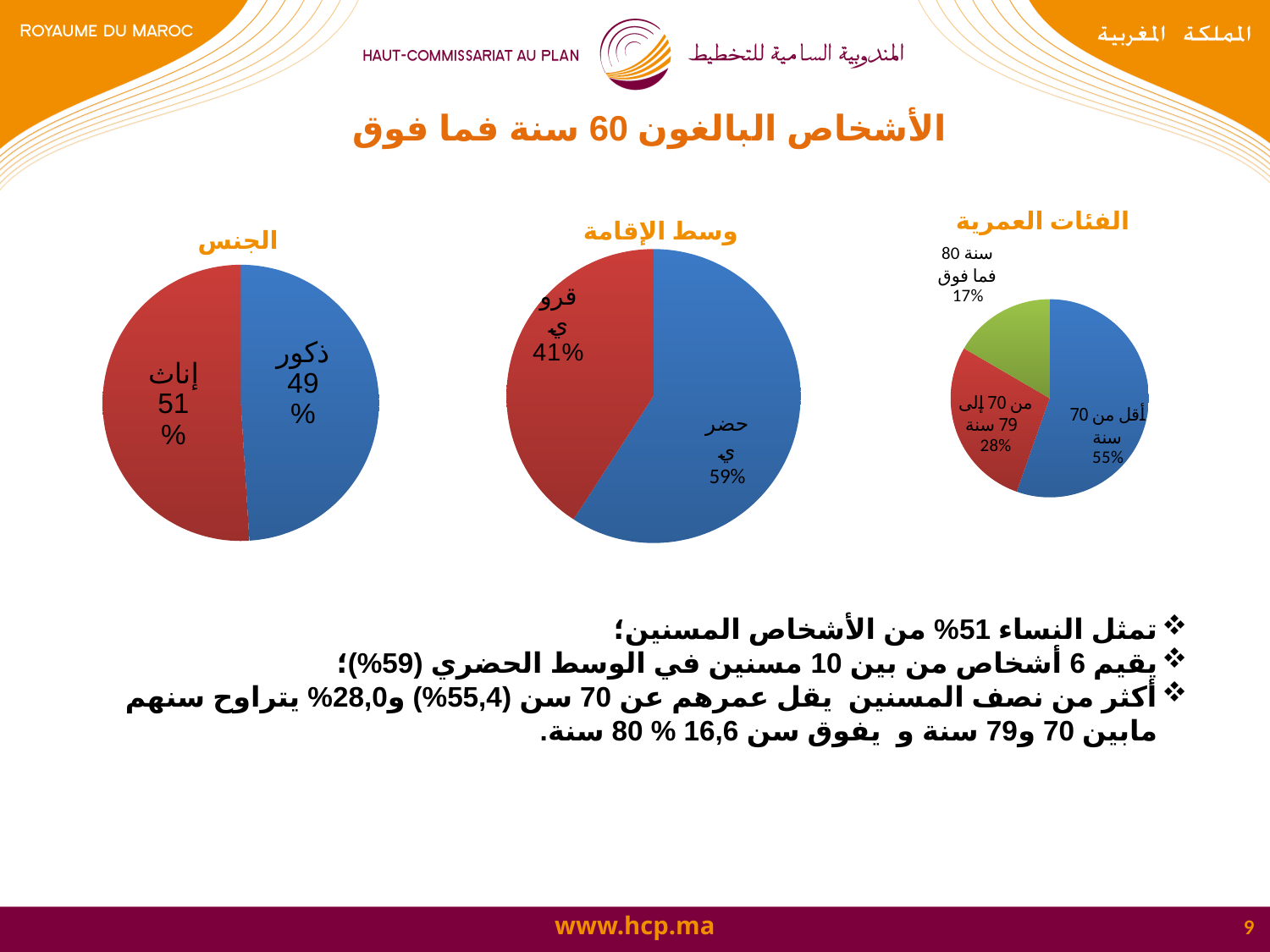
In the chart titled "وسط الإقامة" (place of residence), what share is labelled for قروي (rural)? 41% In the chart titled "وسط الإقامة" (place of residence), what share is labelled for حضري (urban)? 59% In the chart titled "الفئات العمرية" (age groups), which age group has the largest slice? أقل من 70 سنة What type of chart is used for "وسط الإقامة" (place of residence)? Pie chart In the chart titled "الجنس" (gender), what share is labelled for إناث (females)? 51% In the chart titled "الفئات العمرية" (age groups), which age group has the smallest slice? 80 سنة فما فوق In the chart titled "وسط الإقامة" (place of residence), what is the difference in percentage points between حضري (urban) and قروي (rural)? 18 In the chart titled "الجنس" (gender), which slice is larger, إناث (females) or ذكور (males)? إناث In the chart titled "الفئات العمرية" (age groups), what share is labelled for 80 سنة فما فوق (80 years and over)? 17% In the chart titled "الجنس" (gender), what share is labelled for ذكور (males)? 49% How many slices does the chart titled "الفئات العمرية" (age groups) have? 3 In the chart titled "الفئات العمرية" (age groups), what share is labelled for أقل من 70 سنة (under 70 years)? 55%